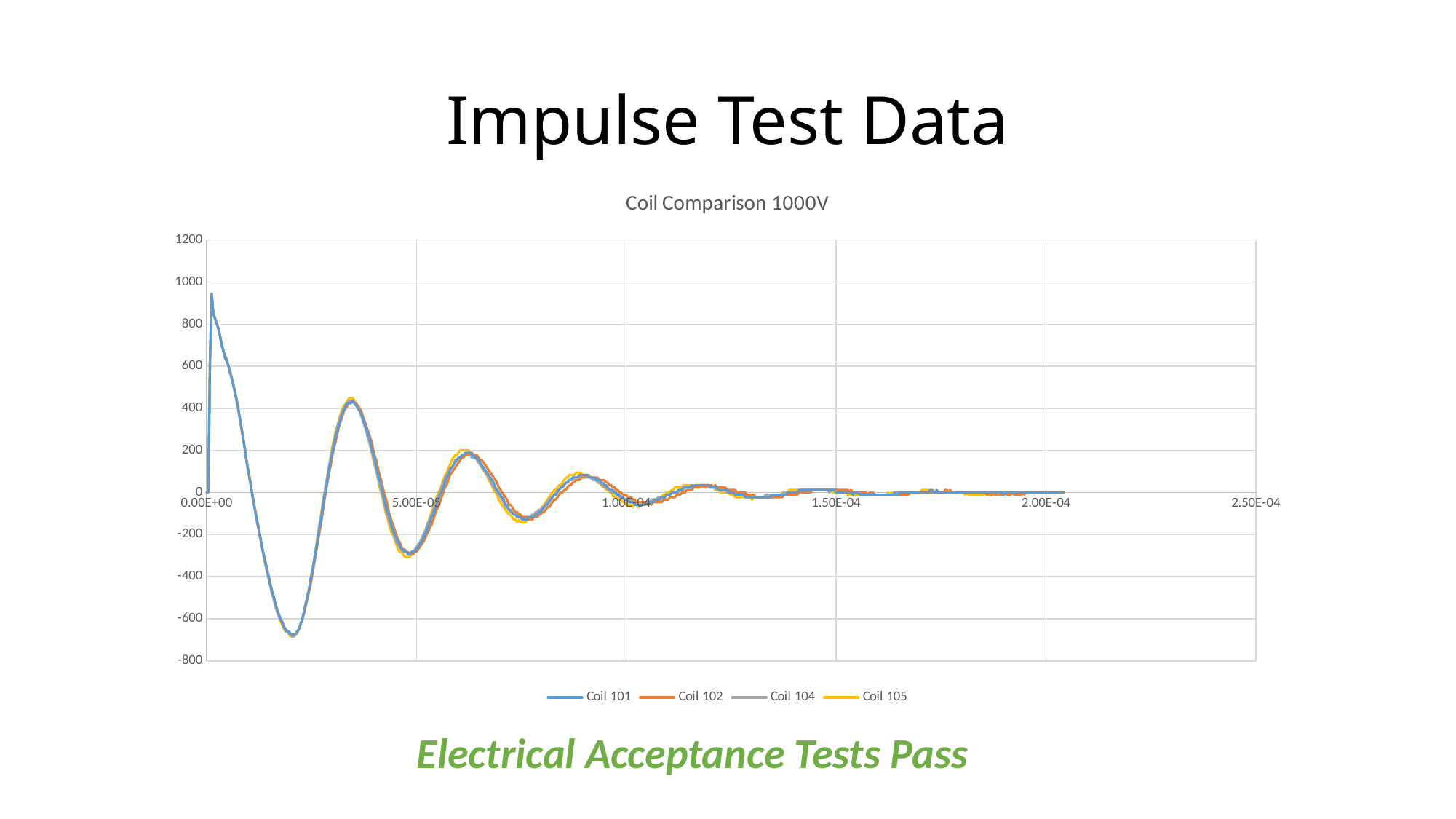
What is the title of the chart? Coil Comparison 1000V Which series is drawn in blue according to the legend? Coil 101 Is the initial peak value of the curves greater or less than 800? greater Is the lowest value reached by the curves (the first trough) greater or less than -600? less Is the second positive peak of the curves greater or less than 600? less What kind of chart is shown on the slide? Line chart Does the amplitude of the oscillations grow or shrink as the x-axis value increases? shrink How many series does the legend list? 4